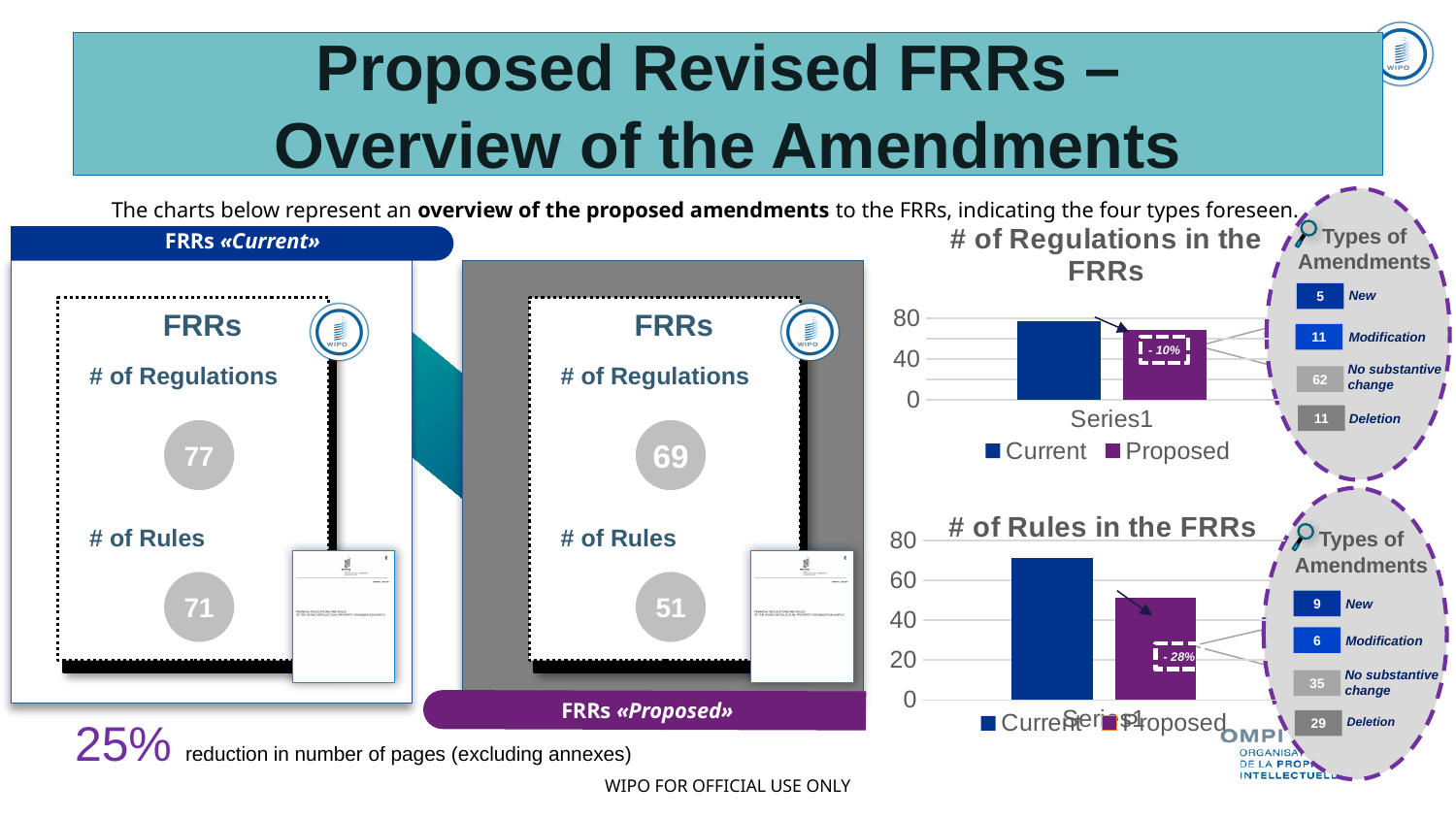
What are the two legend entries of the "# of Regulations in the FRRs" chart? Current and Proposed In the "# of Regulations in the FRRs" chart, which bar is taller, Current or Proposed? Current What percentage change is annotated on the Proposed bar of the "# of Regulations in the FRRs" chart? -10% In the "# of Rules in the FRRs" chart, is the value for Current greater or less than 60? greater How many series does the legend of the "# of Rules in the FRRs" chart list? 2 In the "# of Regulations in the FRRs" chart, is the value for Proposed greater or less than 40? greater In the "# of Rules in the FRRs" chart, is the value for Proposed greater or less than 40? greater What kind of chart is the "# of Regulations in the FRRs" chart? bar chart How many categories are shown on the x axis of the "# of Rules in the FRRs" chart? 1 In the "# of Rules in the FRRs" chart, which series has the lowest value? Proposed